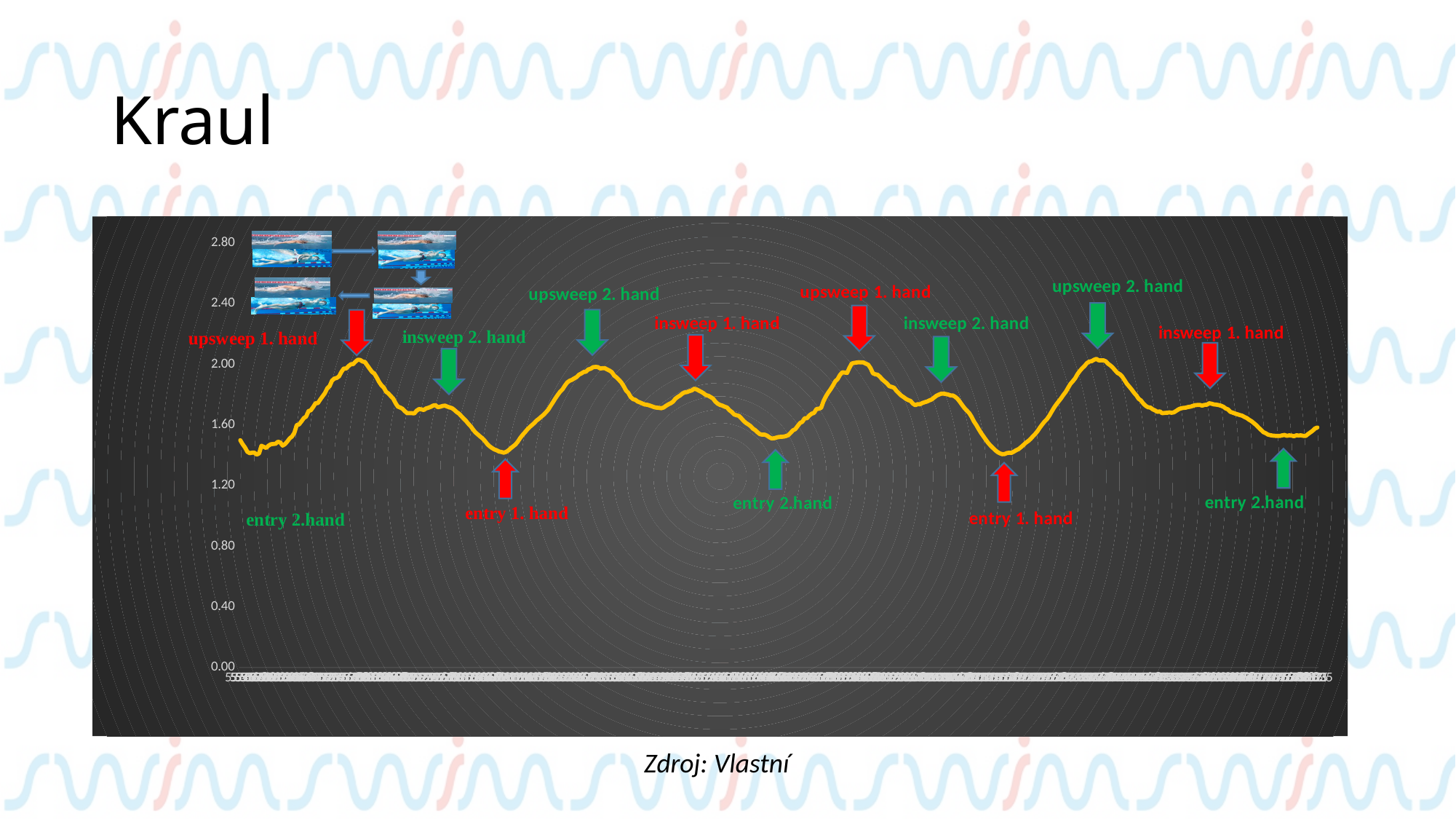
What is the highest value shown on the chart's vertical axis? 2.80 Is the lowest point of the line greater or less than 1.20? greater Is the highest point of the line greater or less than 2.40? less What colour is the plotted line in the chart? yellow What kind of chart is shown on the slide? line chart Is the value at the leftmost start of the line greater or less than 1.20? greater Which is higher: the line at the first "upsweep 1. hand" marker or at the first "entry 1. hand" marker? upsweep 1. hand Does the line rise or fall between the first "upsweep 1. hand" marker and the first "entry 1. hand" marker? falls Which is lower: the line at the second "entry 2.hand" marker (middle of the chart) or at the second "upsweep 2. hand" marker? entry 2.hand Does the line rise or fall between the first "entry 1. hand" marker and the first "upsweep 2. hand" marker? rises